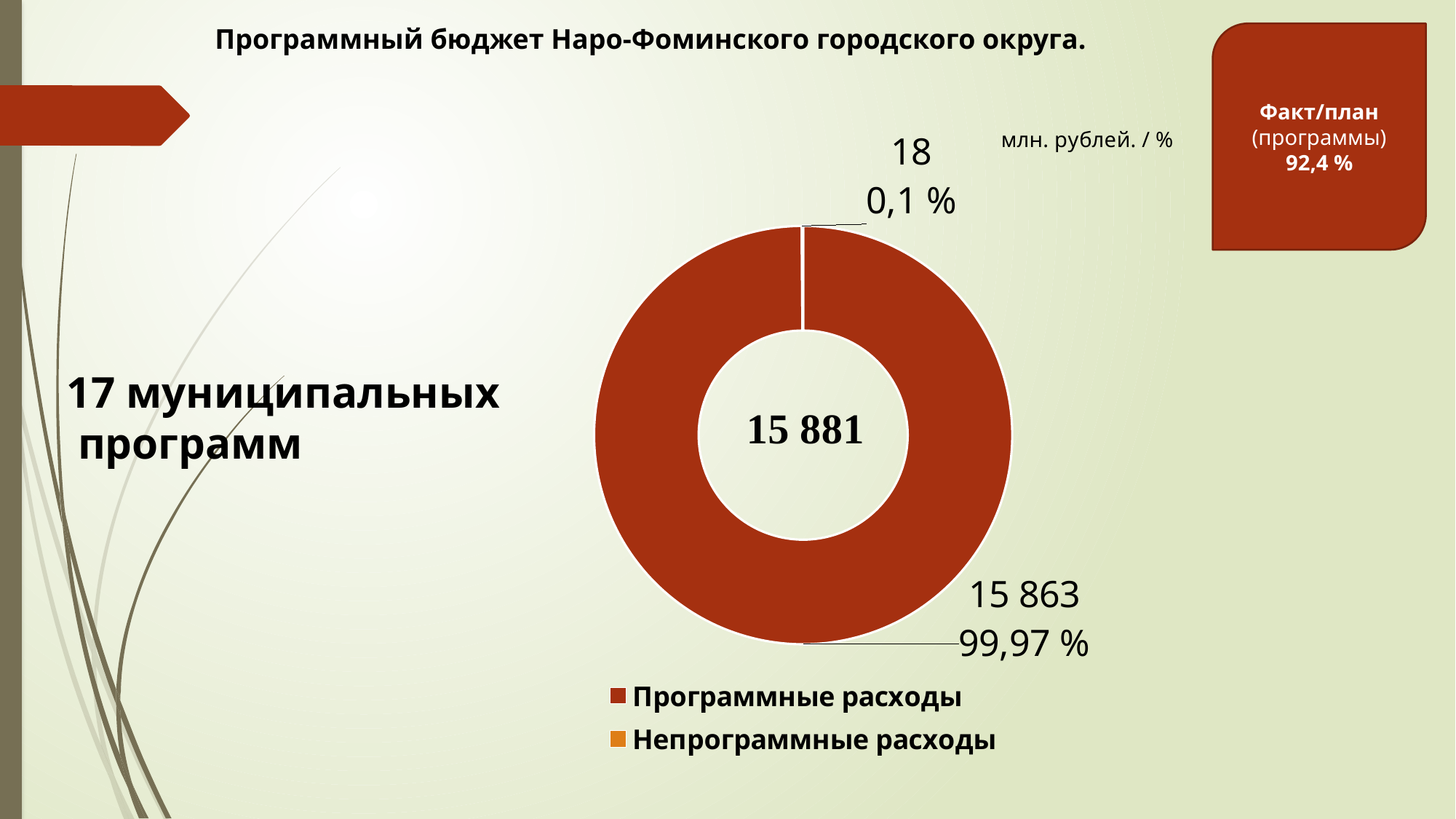
Which category has the largest slice? Программные расходы What is the difference between Программные расходы and Непрограммные расходы? 15 845 What is the value for Программные расходы? 15 863 What kind of chart is shown on the slide? doughnut chart What is the value for Непрограммные расходы? 18 What total value is shown in the centre of the doughnut? 15 881 What percentage share is shown for Непрограммные расходы? 0,1 % How many entries does the legend list? 2 Which is larger, Программные расходы or Непрограммные расходы? Программные расходы What percentage share is shown for Программные расходы? 99,97 % Which category has the smallest slice? Непрограммные расходы What unit is indicated next to the chart? млн. рублей. / %